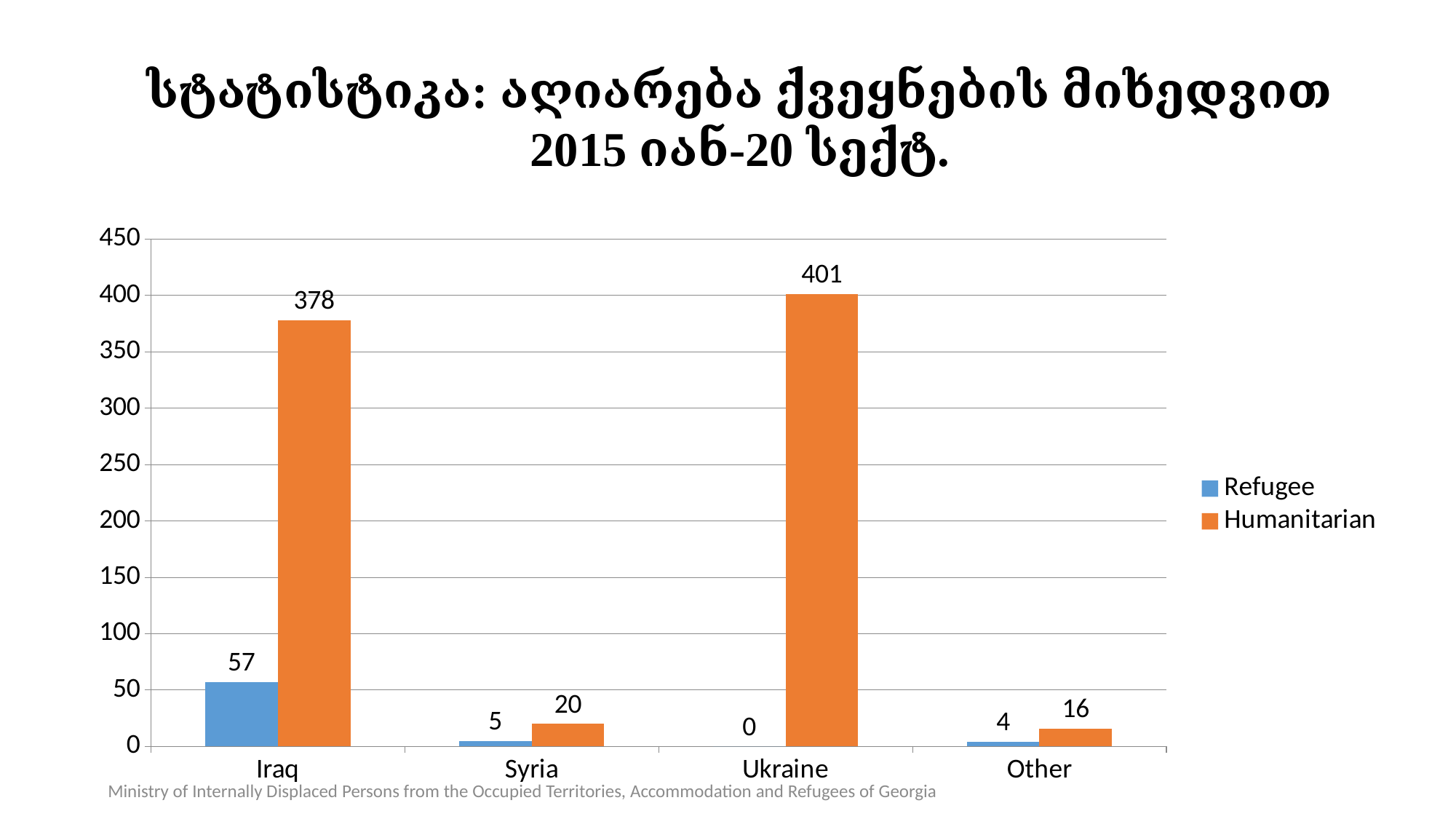
How many categories are shown on the x axis? 4 What is the difference between the Humanitarian values for Ukraine and Iraq? 23 What kind of chart is shown on the slide? bar chart What is the Humanitarian value for Syria? 20 How many series does the legend list? 2 What is the Humanitarian value for Ukraine? 401 Which is larger, the Refugee value for Syria or the Refugee value for Other? Syria Which category has the highest Humanitarian value? Ukraine Which category has the lowest Refugee value? Ukraine What is the Refugee value for Ukraine? 0 Is the Humanitarian value for Iraq greater or less than 350? greater What is the Refugee value for Iraq? 57